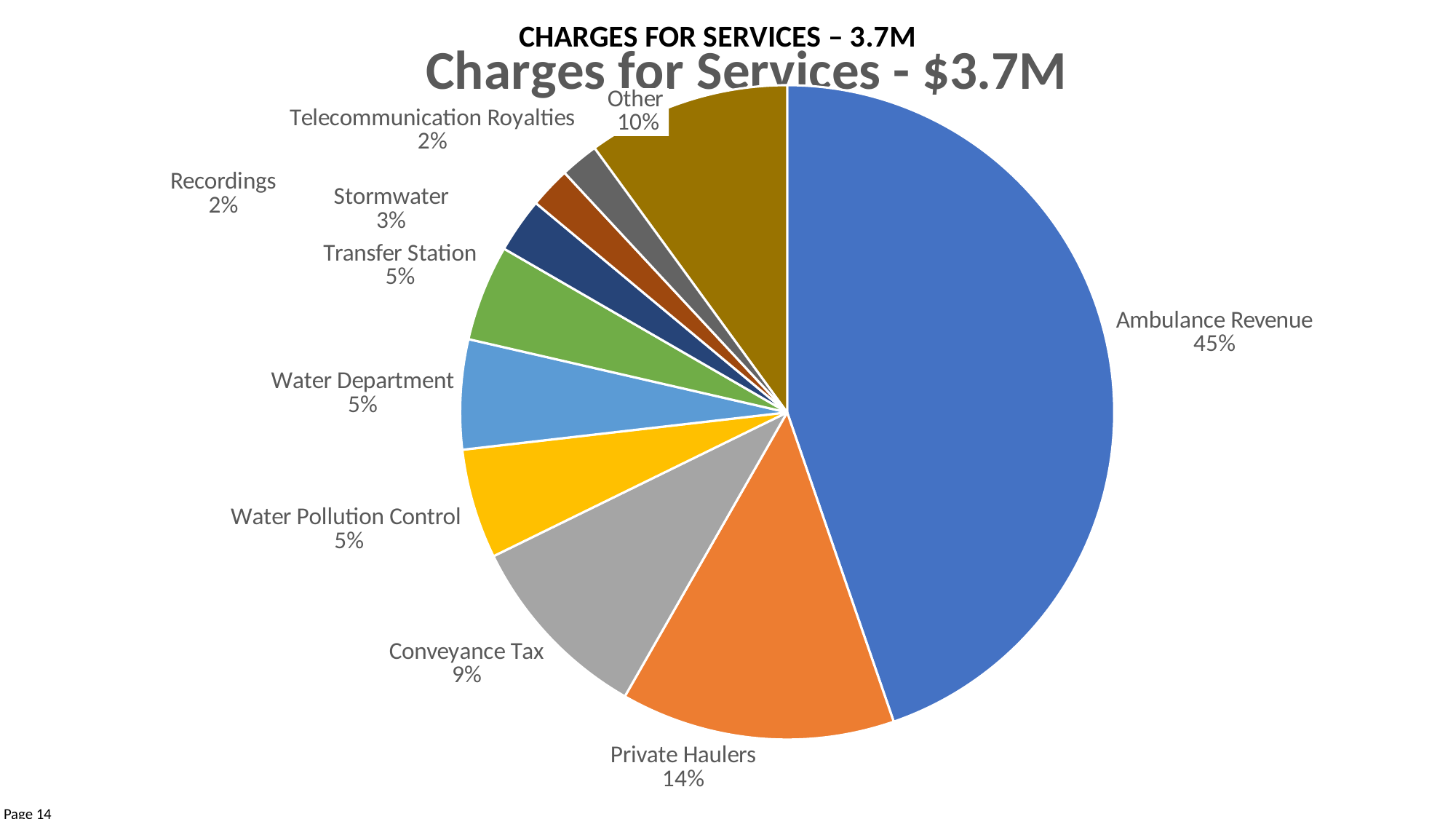
Which category has the largest slice of the pie? Ambulance Revenue How many slices does the pie chart have? 10 What percentage is shown for Private Haulers? 14% What share of the pie does Ambulance Revenue represent? 45% What colour is the Ambulance Revenue slice? blue What percentage is shown for Conveyance Tax? 9% What percentage is shown for Other? 10% What percentage is shown for Stormwater? 3% What is the difference in percentage points between Ambulance Revenue and Private Haulers? 31 What type of chart is shown on the slide? pie chart Which is larger, the share for Conveyance Tax or the share for Other? Other What is the title of the chart? Charges for Services - $3.7M